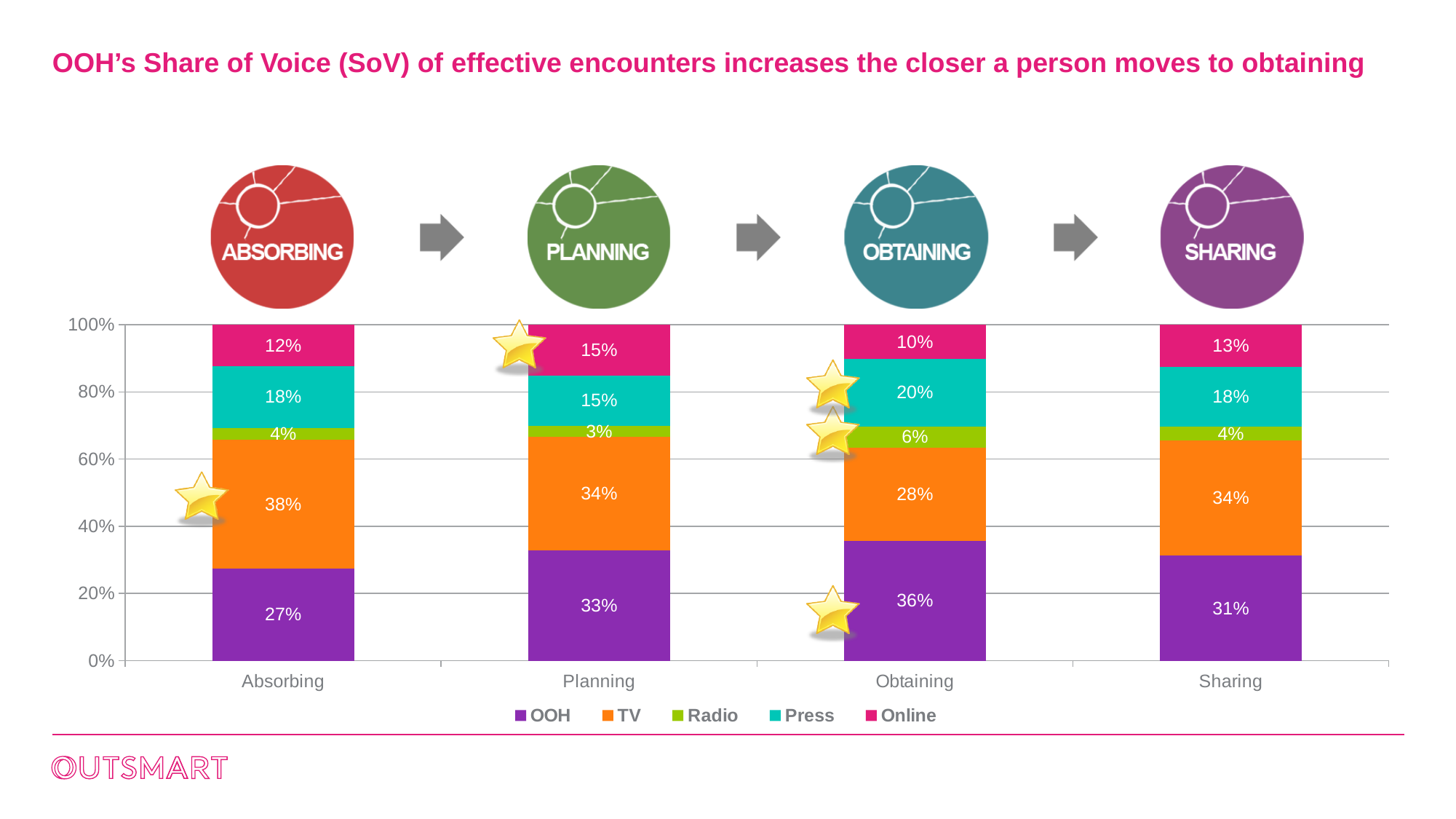
What is the TV share for the Absorbing stage? 38% What is the OOH share for the Obtaining stage? 36% Which stage has the lowest Online share? Obtaining How many stages (categories) are shown on the x axis? 4 What is the difference between the TV share in Absorbing and the TV share in Obtaining? 10% What kind of chart is shown? Stacked bar chart How many series does the legend list? 5 Which stage has the highest OOH share? Obtaining What is the Radio share for the Obtaining stage? 6% Which is larger, the OOH share in Planning or the OOH share in Sharing? OOH share in Planning What is the Press share for the Planning stage? 15% Which series is shown in orange in the legend? TV